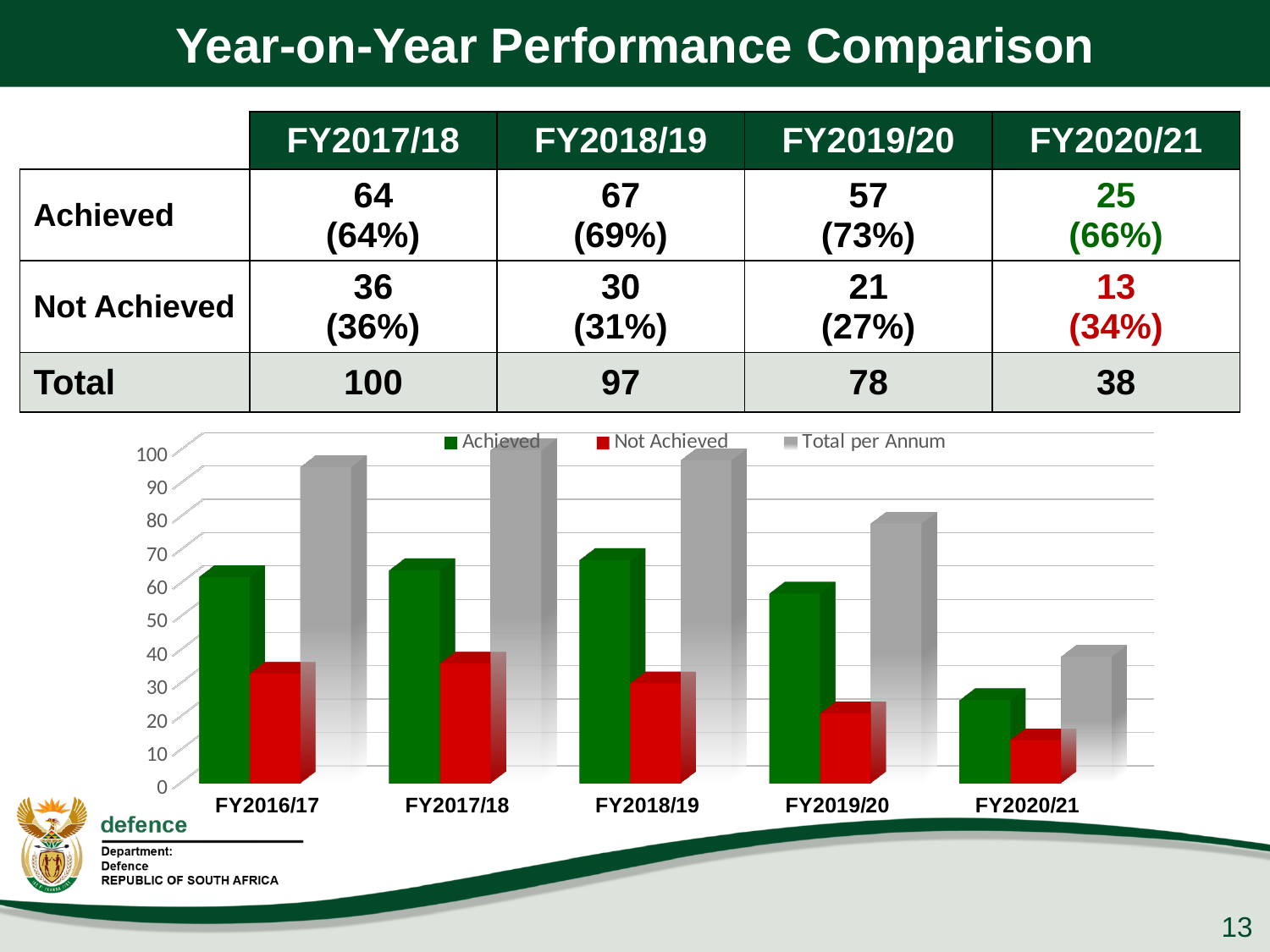
Which financial year has the lowest Total per Annum bar in the chart? FY2020/21 In FY2019/20, which is larger in the chart: Achieved or Not Achieved? Achieved Is the Not Achieved value for FY2020/21 in the chart greater or less than 20? less How many series does the chart legend list? 3 Which financial year has the lowest Achieved bar in the chart? FY2020/21 Is the Achieved value for FY2016/17 in the chart greater or less than 50? greater What is the name of the third series in the chart legend? Total per Annum Does the Total per Annum series rise or fall from FY2018/19 to FY2020/21? fall Which colour represents the Not Achieved series in the chart? red Is the Total per Annum value for FY2016/17 in the chart greater or less than 90? greater How many financial years are shown on the x axis of the chart? 5 What kind of chart is shown on the slide? bar chart